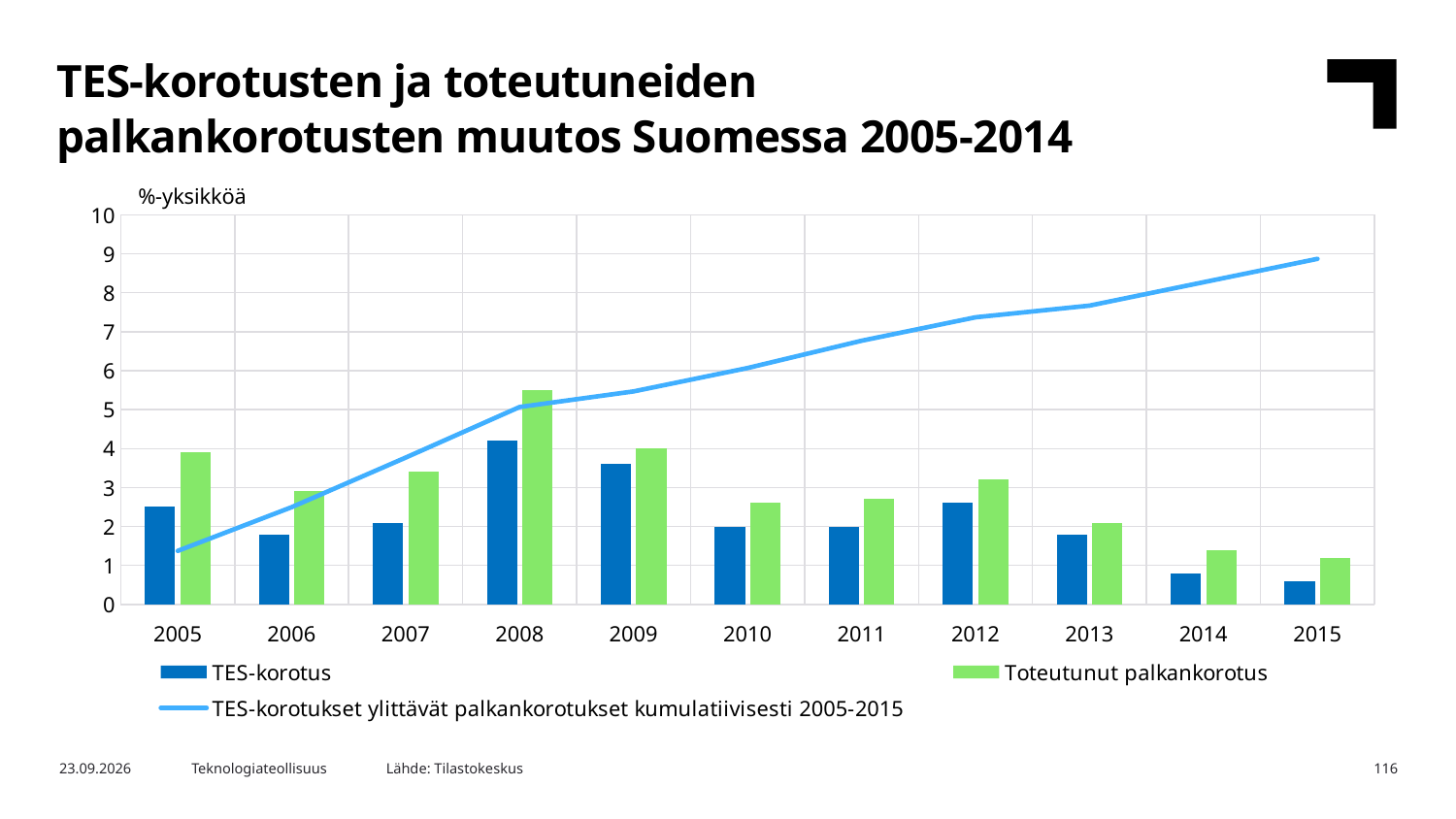
Does the cumulative line (TES-korotukset ylittävät palkankorotukset kumulatiivisesti 2005-2015) rise or fall from 2005 to 2015? It rises How many series does the chart's legend list? 3 In 2005, which is larger: TES-korotus or Toteutunut palkankorotus? Toteutunut palkankorotus How many years are shown on the x axis of the chart? 11 In which year is the Toteutunut palkankorotus bar the lowest? 2015 In which year is the Toteutunut palkankorotus bar the highest? 2008 Is the value of the cumulative line (TES-korotukset ylittävät palkankorotukset kumulatiivisesti 2005-2015) in 2015 greater or less than 8? greater What kind of chart is shown on the slide? A bar chart combined with a line In which year is the TES-korotus bar the highest? 2008 Is the Toteutunut palkankorotus value for 2008 greater or less than 5? greater Is the TES-korotus value for 2014 greater or less than 1? less In which year is the TES-korotus bar the lowest? 2015